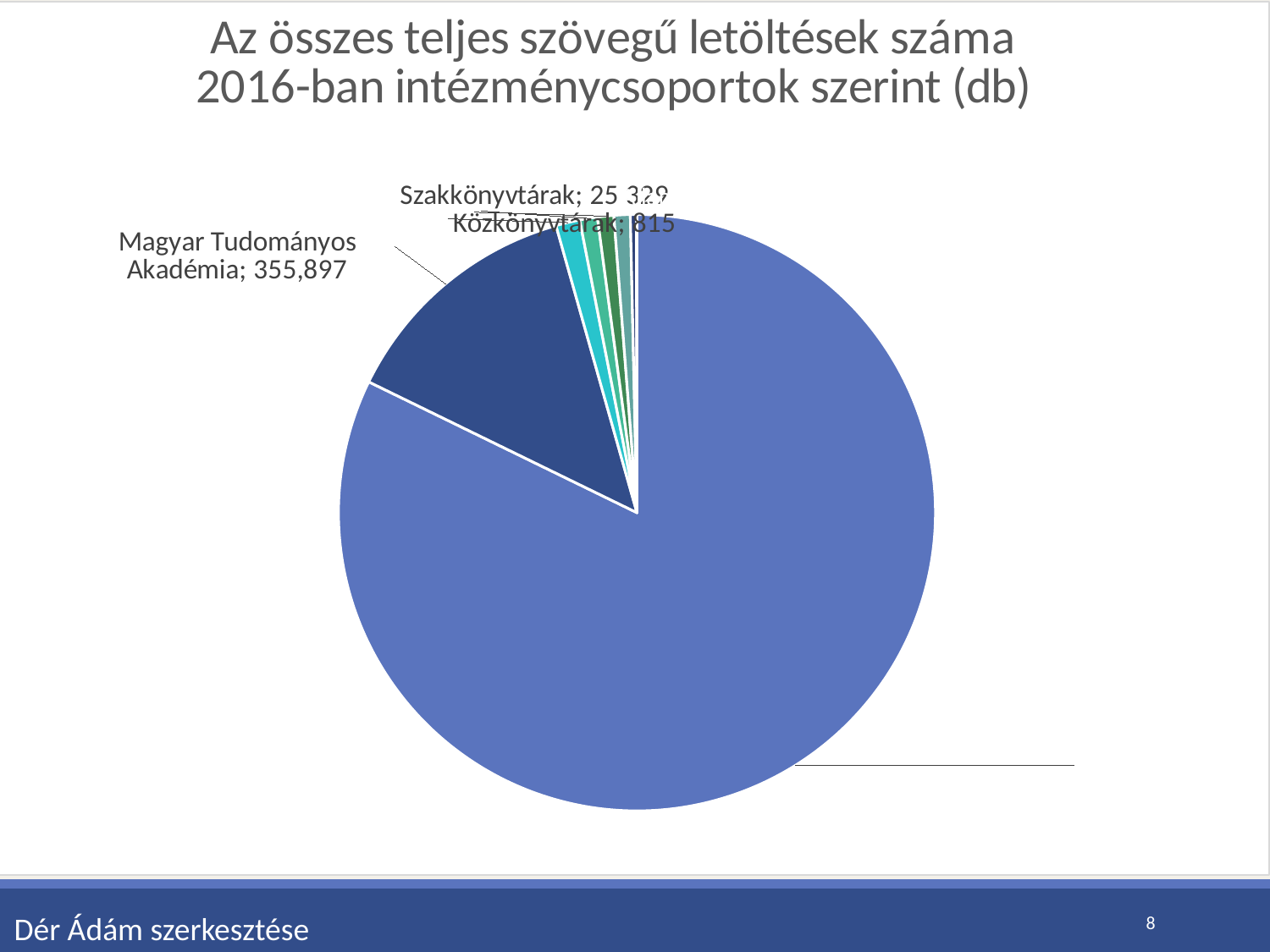
Which has the larger value, Magyar Tudományos Akadémia or Közkönyvtárak? Magyar Tudományos Akadémia What kind of chart is shown on the slide? Pie chart Is the Magyar Tudományos Akadémia slice the largest slice of the pie? No What is the value shown for Közkönyvtárak? 815 What is the value shown for Magyar Tudományos Akadémia? 355,897 What colour is the Magyar Tudományos Akadémia slice? Dark blue What is the difference between the values for Magyar Tudományos Akadémia and Közkönyvtárak? 355,082 What is the title of the chart? Az összes teljes szövegű letöltések száma 2016-ban intézménycsoportok szerint (db)